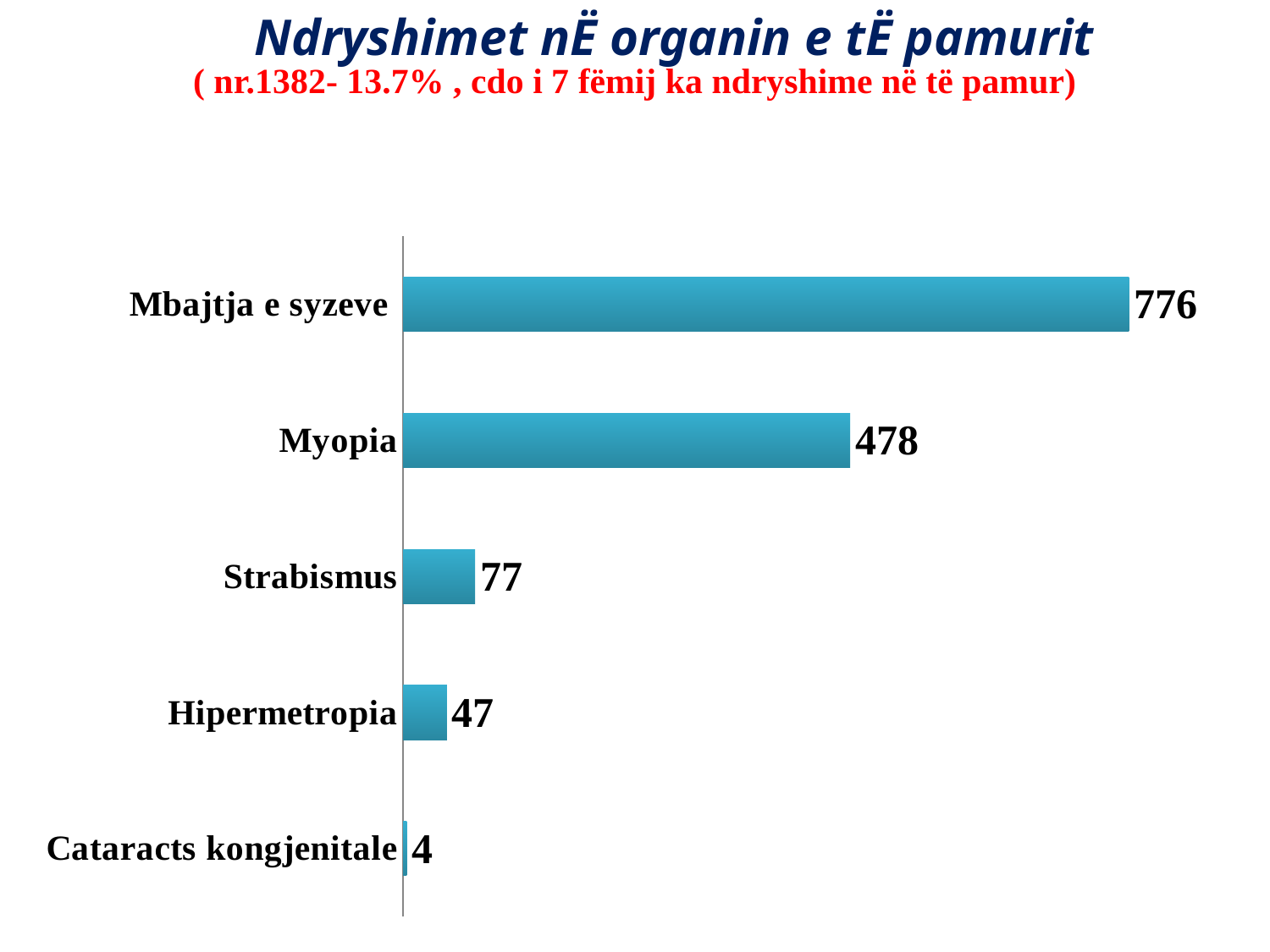
Which category has the highest value? Mbajtja e syzeve Which category has the lowest value? Cataracts kongjenitale How many categories are shown in the chart? 5 What is the difference between the values for Strabismus and Hipermetropia? 30 What is the difference between the values for Mbajtja e syzeve and Myopia? 298 What is the value for Strabismus? 77 What is the value for Cataracts kongjenitale? 4 What is the value for Mbajtja e syzeve? 776 Which is larger, the value for Myopia or the value for Strabismus? Myopia What kind of chart is shown on the slide? Bar chart What is the value for Myopia? 478 What is the value for Hipermetropia? 47